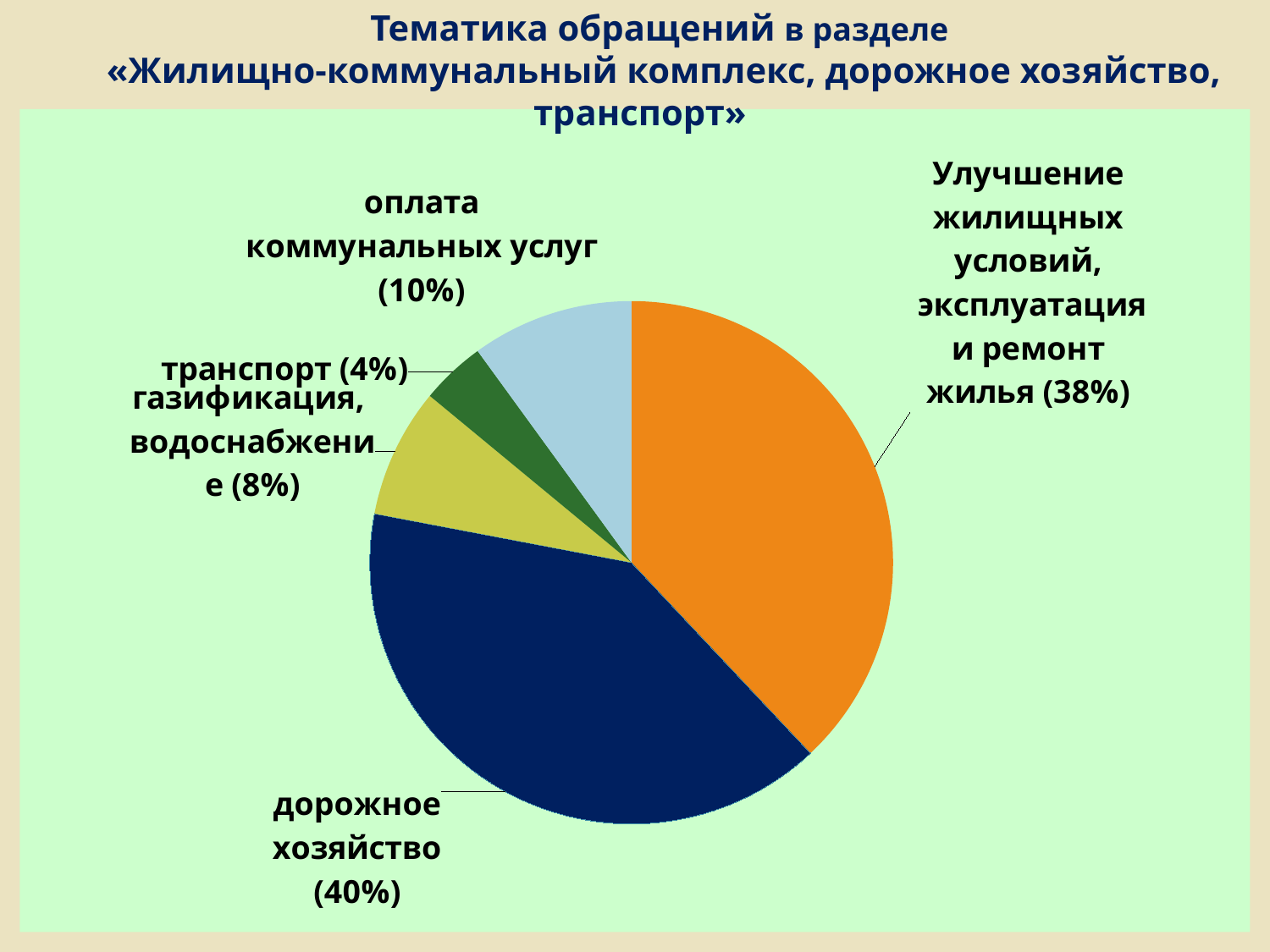
What is the difference in percentage points between «дорожное хозяйство» and «оплата коммунальных услуг»? 30 How many categories (slices) does the pie chart have? 5 Which category has the largest share of the pie? дорожное хозяйство Which category has the smallest share of the pie? транспорт What share of the pie does «Улучшение жилищных условий, эксплуатация и ремонт жилья» take? 38% What share of the pie does «оплата коммунальных услуг» take? 10% What colour is the slice for «дорожное хозяйство»? dark blue What kind of chart is shown on the slide? pie chart Which is larger: the share for «газификация, водоснабжение» or the share for «транспорт»? газификация, водоснабжение What share of the pie does «газификация, водоснабжение» take? 8%